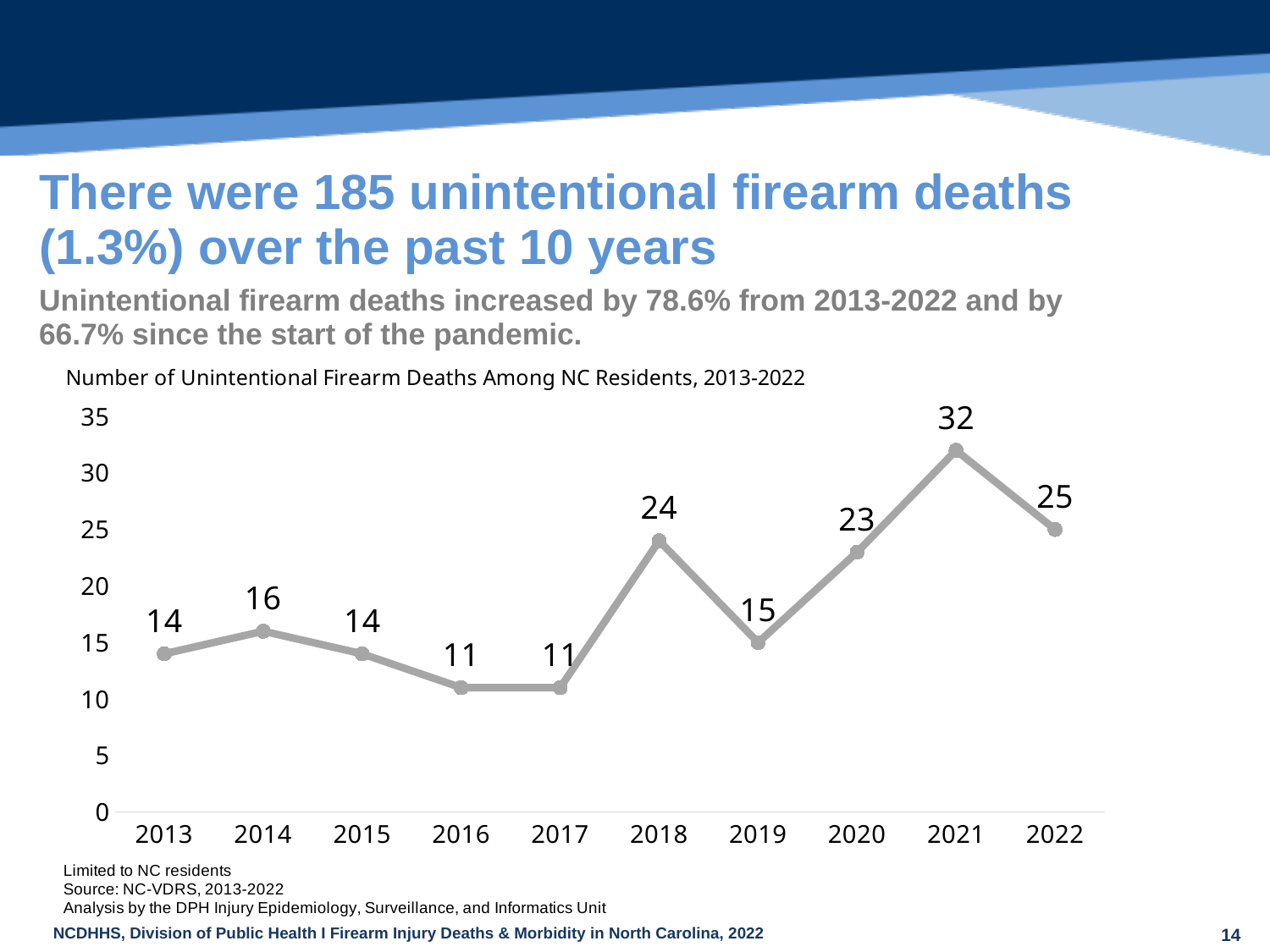
What is the difference between the number of deaths in 2022 and in 2013? 11 Which year has the highest number of unintentional firearm deaths? 2021 What is the number of unintentional firearm deaths in 2018? 24 What is the difference between the number of deaths in 2021 and in 2022? 7 Is the value for 2019 greater or less than 20? less How many years are plotted on the chart? 10 Which year had more unintentional firearm deaths, 2018 or 2020? 2018 What is the number of unintentional firearm deaths in 2021? 32 What is the lowest value plotted on the chart? 11 What is the number of unintentional firearm deaths in 2013? 14 What kind of chart is shown on the slide? line chart What is the title of the chart? Number of Unintentional Firearm Deaths Among NC Residents, 2013-2022